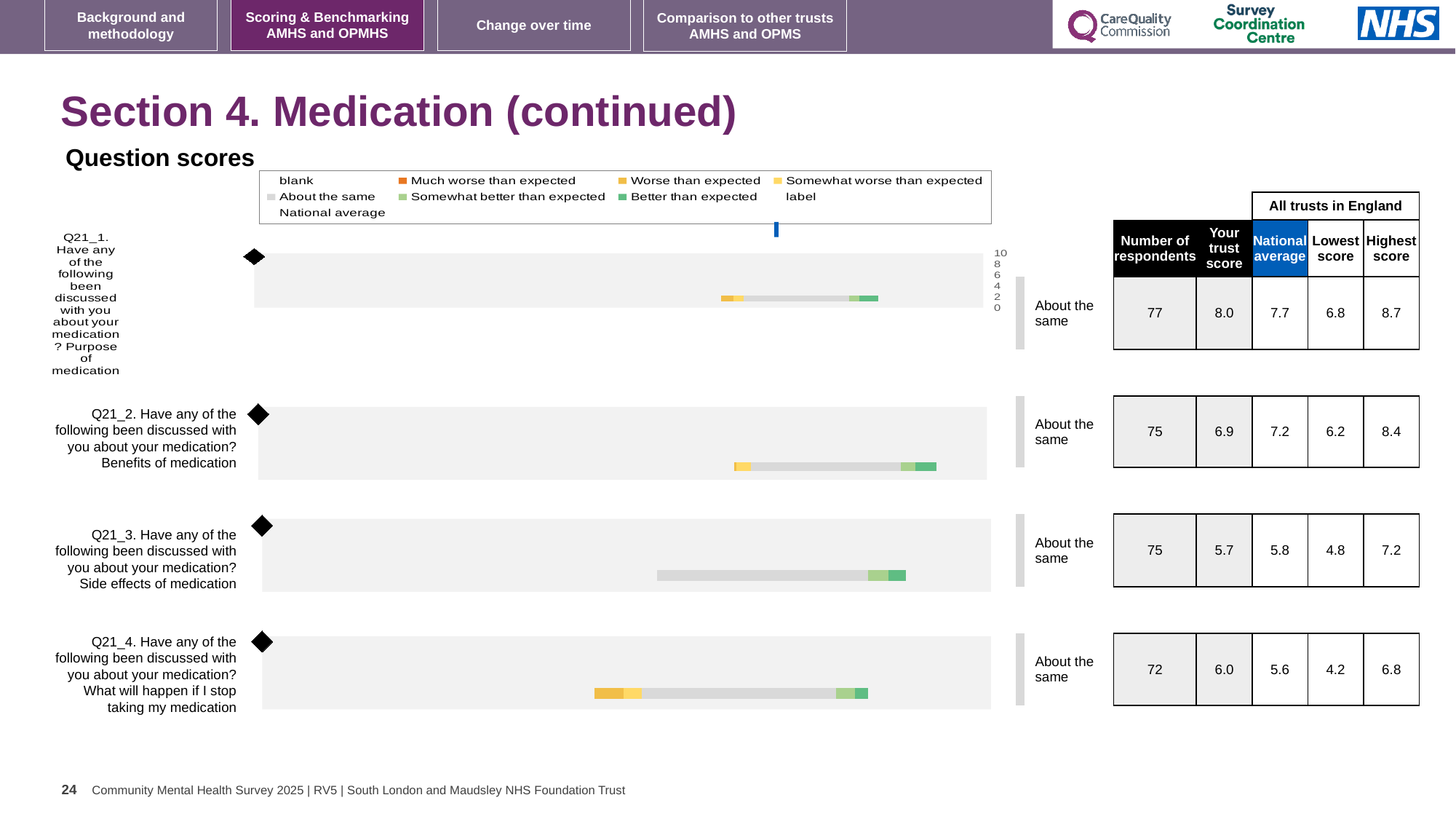
What is the highest score among all trusts in England for Q21_2 (Benefits of medication)? 8.4 What is the 'Your trust score' for Q21_1 (Purpose of medication)? 8.0 In the legend, what colour represents 'Better than expected'? green For Q21_2, what is the difference between the highest score (8.4) and the lowest score (6.2)? 2.2 For Q21_1, which is larger: the trust score or the national average? Your trust score (8.0) What kind of chart is used to show the question scores on this slide? bar chart How many questions (Q21_1 to Q21_4) have a bar chart on this slide? 4 Which question has the highest 'Your trust score' on this slide? Q21_1 (Purpose of medication) In the legend, what colour represents 'Much worse than expected'? orange How many respondents are listed for Q21_4 (What will happen if I stop taking my medication)? 72 What is the national average for Q21_3 (Side effects of medication)? 5.8 Which question has the lowest 'Your trust score' on this slide? Q21_3 (Side effects of medication)